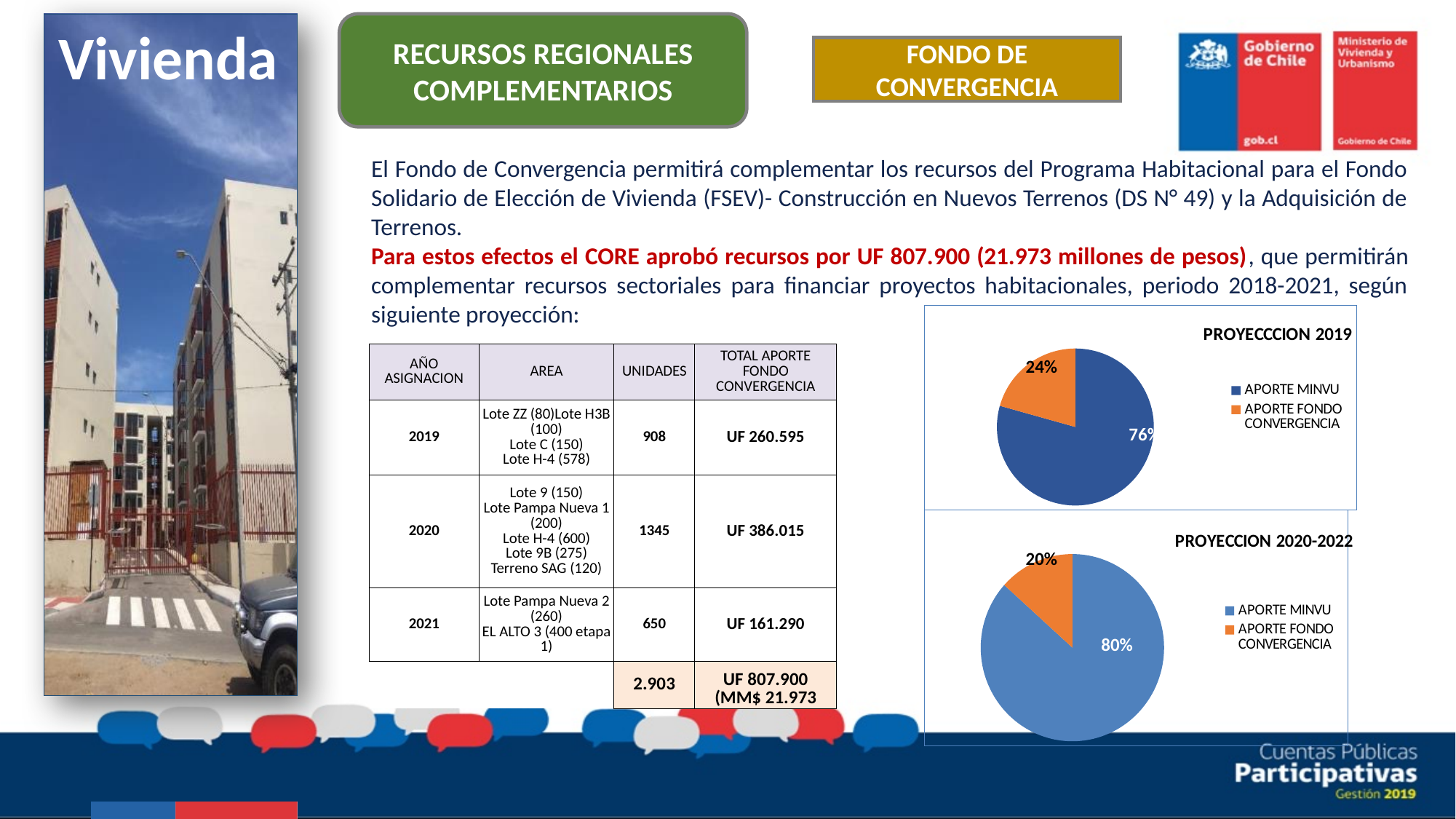
How many slices does the PROYECCCION 2019 pie chart have? 2 Which is larger: the APORTE FONDO CONVERGENCIA share in the PROYECCCION 2019 chart or in the PROYECCION 2020-2022 chart? PROYECCCION 2019 In the PROYECCCION 2019 chart, which slice is the largest? APORTE MINVU In the PROYECCION 2020-2022 chart, what share does APORTE FONDO CONVERGENCIA have? 20% How many entries does the legend of the PROYECCION 2020-2022 chart list? 2 In the PROYECCCION 2019 chart, what is the difference between the APORTE MINVU share and the APORTE FONDO CONVERGENCIA share? 52% In the PROYECCION 2020-2022 chart, which slice is the smallest? APORTE FONDO CONVERGENCIA In the PROYECCION 2020-2022 chart, what share does APORTE MINVU have? 80% In the PROYECCION 2020-2022 chart, what colour is the APORTE FONDO CONVERGENCIA slice? Orange In the PROYECCCION 2019 chart, what share does APORTE FONDO CONVERGENCIA have? 24% What kind of chart is the PROYECCION 2020-2022 chart? Pie chart